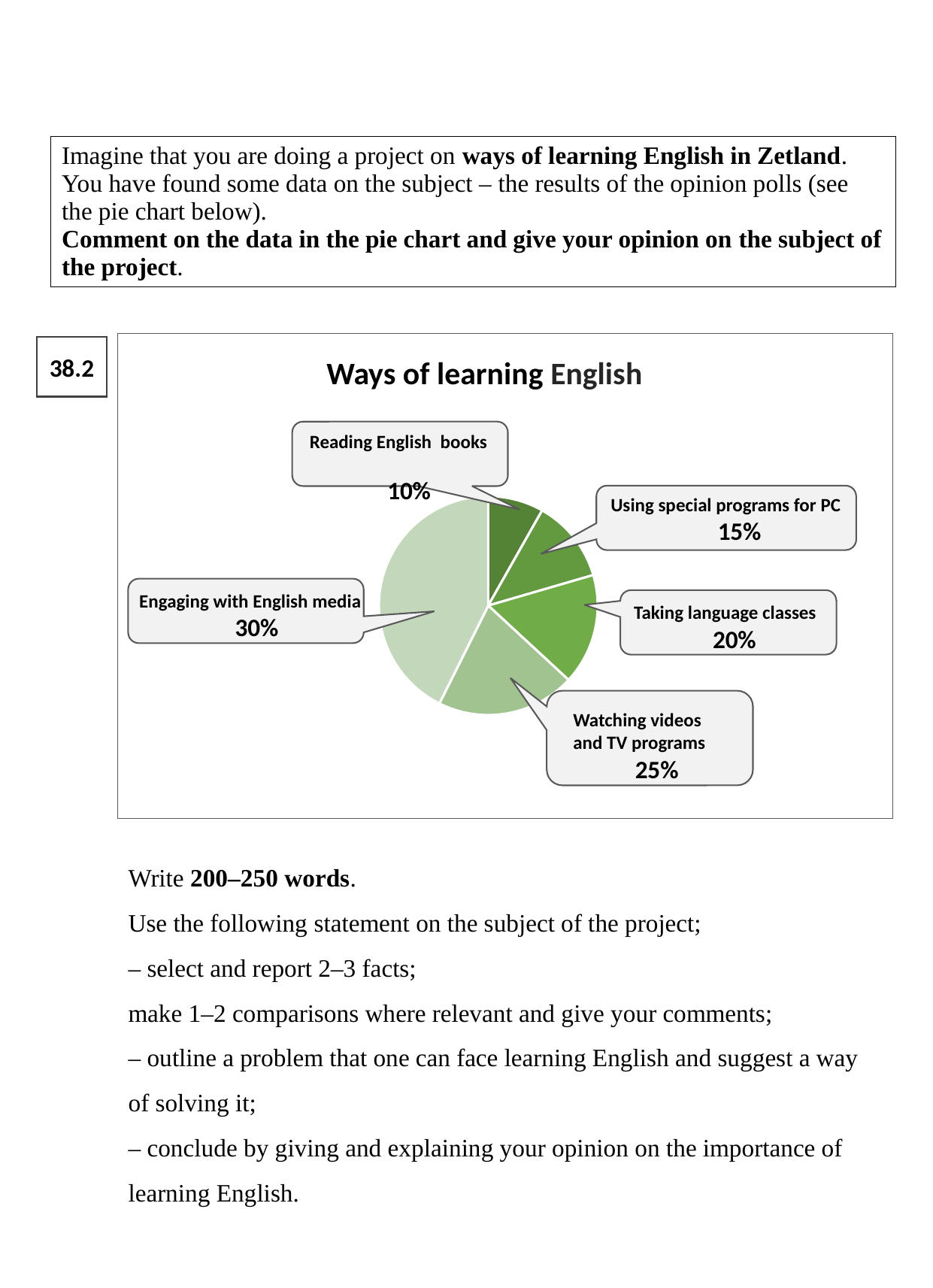
What is the difference in percentage points between Engaging with English media and Reading English books? 20 Which is larger: the share for Taking language classes or the share for Watching videos and TV programs? Watching videos and TV programs What is the value shown for Taking language classes? 20% How many categories are shown in the pie chart? 5 Which way of learning English has the largest share in the pie chart? Engaging with English media Which way of learning English has the smallest share in the pie chart? Reading English books What type of chart is shown on the slide? Pie chart What share does Watching videos and TV programs have in the pie chart? 25% What percentage of the pie chart is for Engaging with English media? 30% What is the value for Reading English books? 10% What is the title of the chart? Ways of learning English What percentage is shown for Using special programs for PC? 15%